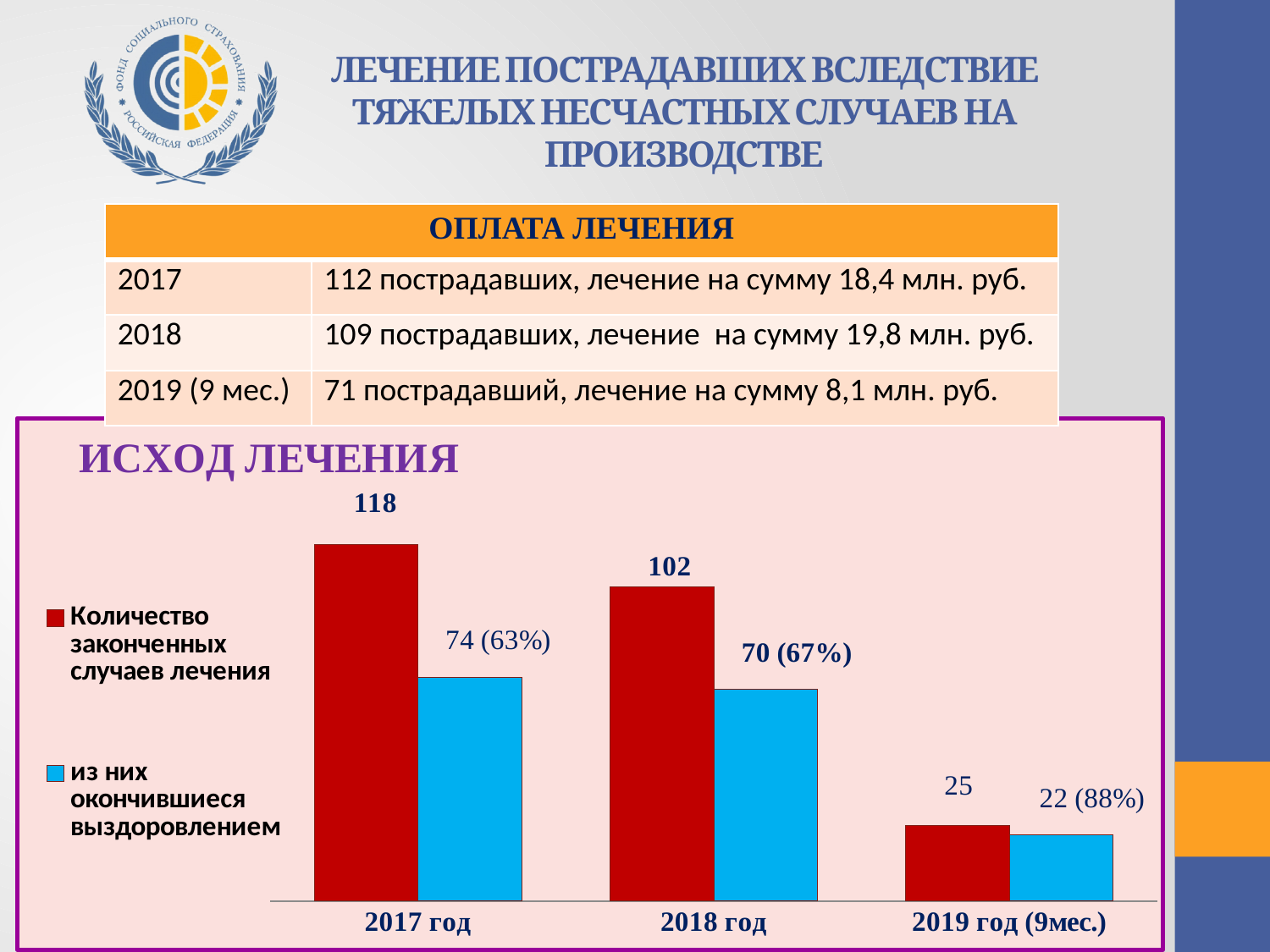
What is the difference between "Количество законченных случаев лечения" for 2017 год and 2018 год? 16 What is the value of "Количество законченных случаев лечения" for 2018 год? 102 How many series does the legend of the "ИСХОД ЛЕЧЕНИЯ" chart list? 2 Which category has the highest value of "Количество законченных случаев лечения"? 2017 год What type of chart is shown under the heading "ИСХОД ЛЕЧЕНИЯ"? Bar chart Do the values of "Количество законченных случаев лечения" rise or fall from 2017 год to 2019 год (9мес.)? Fall What is the value of "Количество законченных случаев лечения" for 2017 год? 118 How many categories are shown on the x axis of the "ИСХОД ЛЕЧЕНИЯ" chart? 3 What is the data label for "из них окончившиеся выздоровлением" for 2017 год? 74 (63%) What is the data label for "из них окончившиеся выздоровлением" for 2019 год (9мес.)? 22 (88%) Which is larger: "Количество законченных случаев лечения" for 2018 год or "из них окончившиеся выздоровлением" for 2018 год? Количество законченных случаев лечения Which category has the lowest value of "из них окончившиеся выздоровлением"? 2019 год (9мес.)